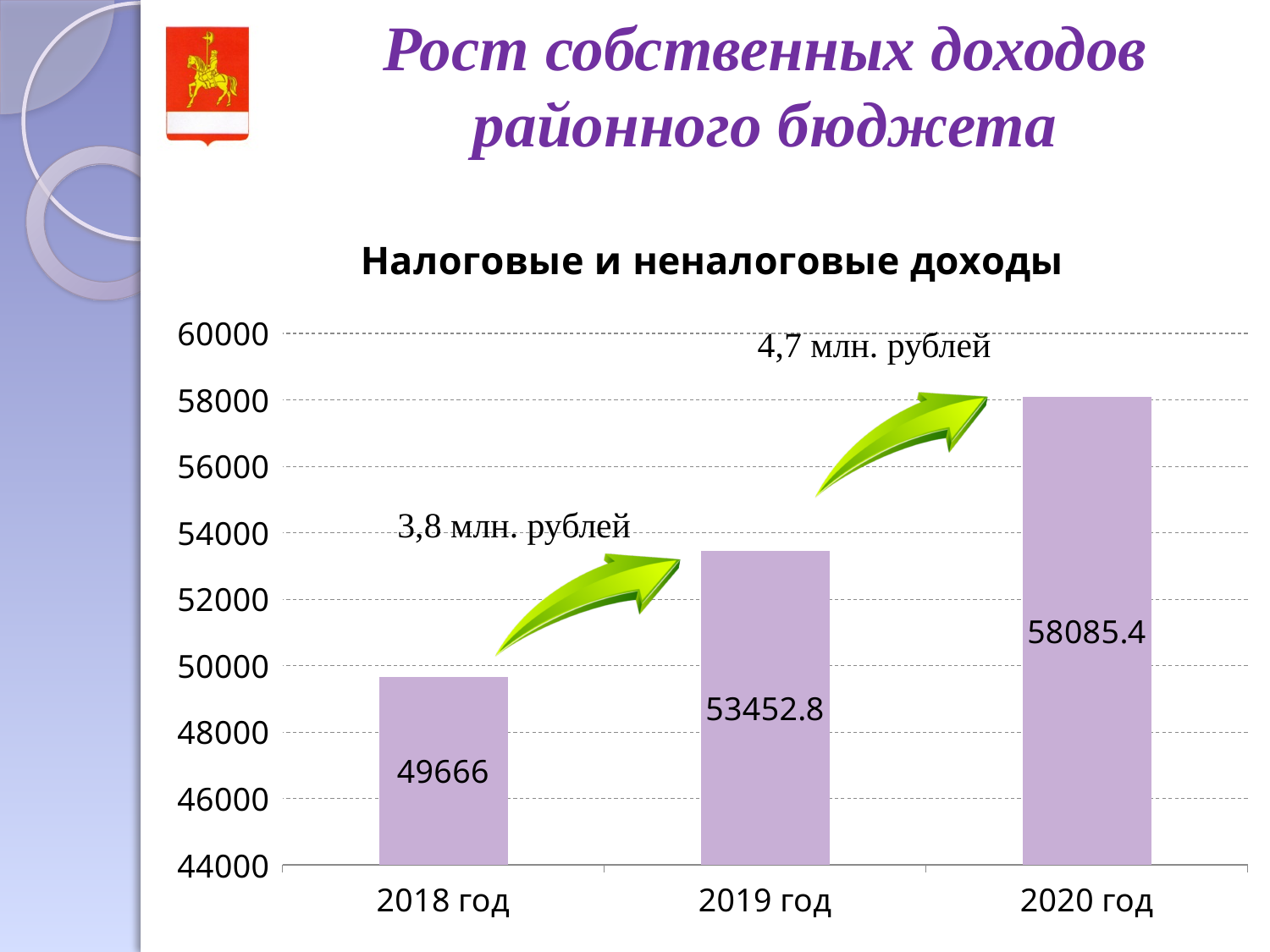
What is the value for 2020 год? 58085.4 Which year has the highest value? 2020 год Which year has the lowest value? 2018 год Is the value for 2018 год greater or less than 50000? less What is the difference between the values for 2020 год and 2019 год? 4632.6 What is the value for 2019 год? 53452.8 What kind of chart is shown on the slide? bar chart How many years are shown on the chart? 3 What is the value for 2018 год? 49666 Which is larger, the value for 2019 год or the value for 2018 год? 2019 год What is the difference between the values for 2019 год and 2018 год? 3786.8 Do the values rise or fall from 2018 год to 2020 год? rise